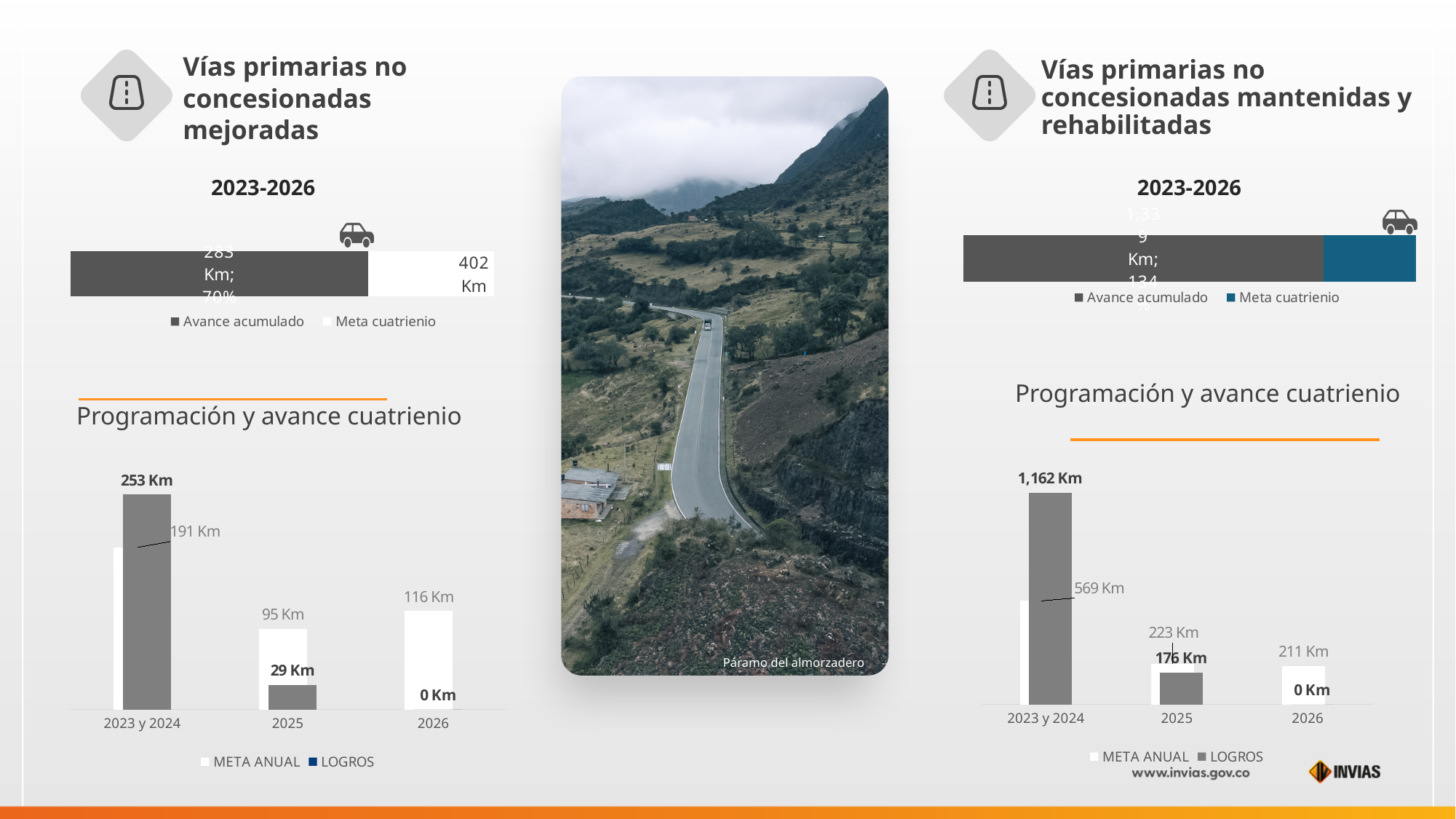
In the 'Programación y avance cuatrienio' chart under 'Vías primarias no concesionadas mejoradas' (bottom left), what is the LOGROS value for 2023 y 2024? 253 Km How many series does the legend of the top-right '2023-2026' chart list? 2 In the bottom-left 'Programación y avance cuatrienio' chart, what is the META ANUAL value for 2025? 95 Km In the bottom-left 'Programación y avance cuatrienio' chart, which year has the highest META ANUAL value? 2023 y 2024 In the bottom-right 'Programación y avance cuatrienio' chart (under 'Vías primarias no concesionadas mantenidas y rehabilitadas'), what is the LOGROS value for 2023 y 2024? 1,162 Km In the '2023-2026' chart under 'Vías primarias no concesionadas mejoradas' (top left), what is the Meta cuatrienio value? 402 Km In the bottom-right 'Programación y avance cuatrienio' chart, what is the META ANUAL value for 2026? 211 Km In the bottom-left 'Programación y avance cuatrienio' chart, what is the difference between META ANUAL and LOGROS for 2023 y 2024? 62 Km In the bottom-right 'Programación y avance cuatrienio' chart, what is the difference between LOGROS and META ANUAL for 2023 y 2024? 593 Km In the bottom-right 'Programación y avance cuatrienio' chart, which is larger for 2025: META ANUAL or LOGROS? META ANUAL In the bottom-left 'Programación y avance cuatrienio' chart, what is the LOGROS value for 2026? 0 Km How many categories are shown on the x axis of the bottom-right 'Programación y avance cuatrienio' chart? 3